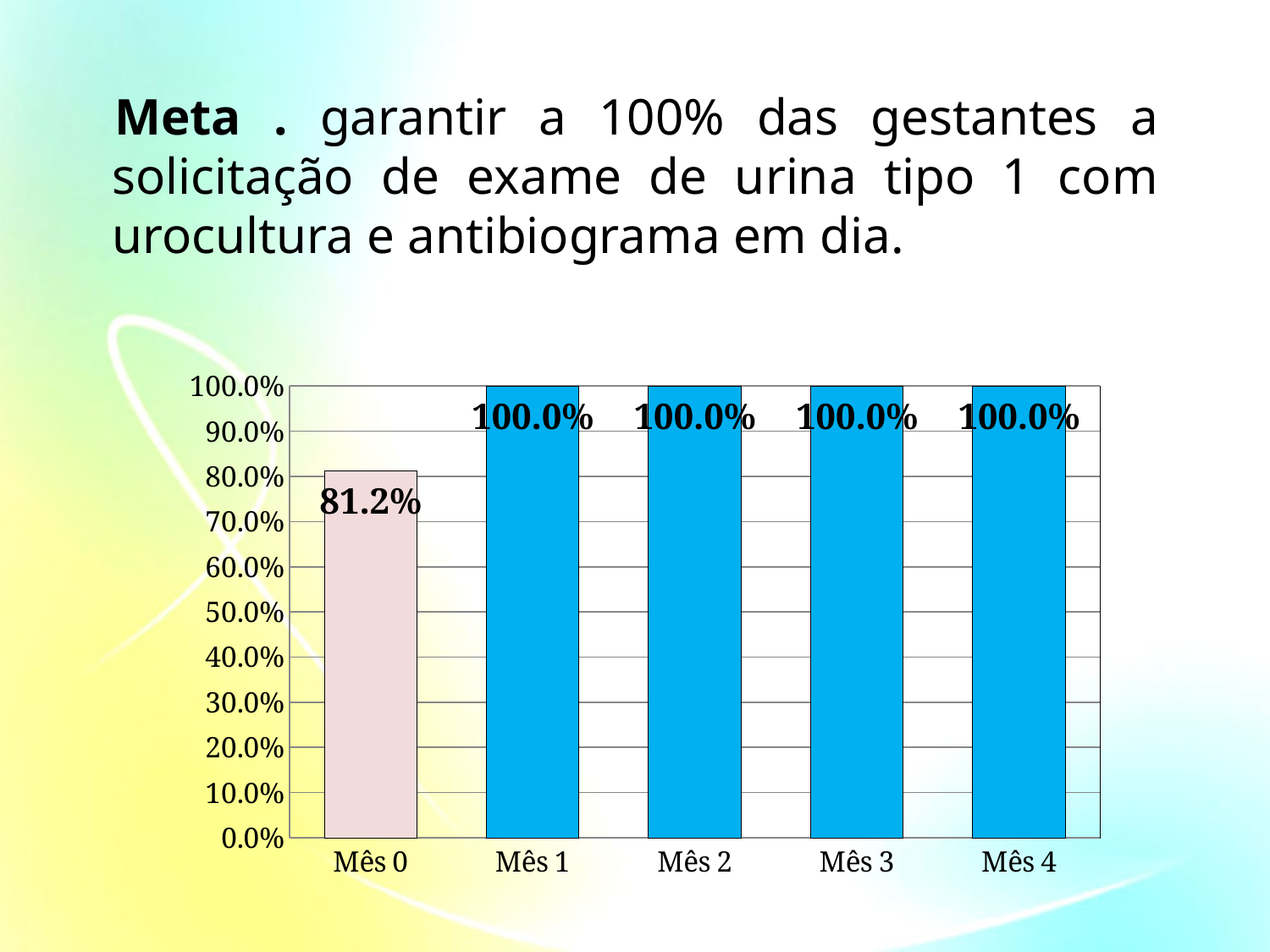
How many categories have a value of 100.0%? 4 How many categories are shown on the x axis? 5 What colour is the bar for Mês 0? pink What is the value for Mês 4? 100.0% What is the value for Mês 0? 81.2% Which is larger, the value for Mês 0 or the value for Mês 3? Mês 3 Is the value for Mês 0 greater or less than 90%? less What is the value for Mês 2? 100.0% Do the values rise or fall from Mês 0 to Mês 1? rise Which category has the lowest value? Mês 0 What kind of chart is shown on the slide? bar chart What is the difference between the values for Mês 1 and Mês 0? 18.8%